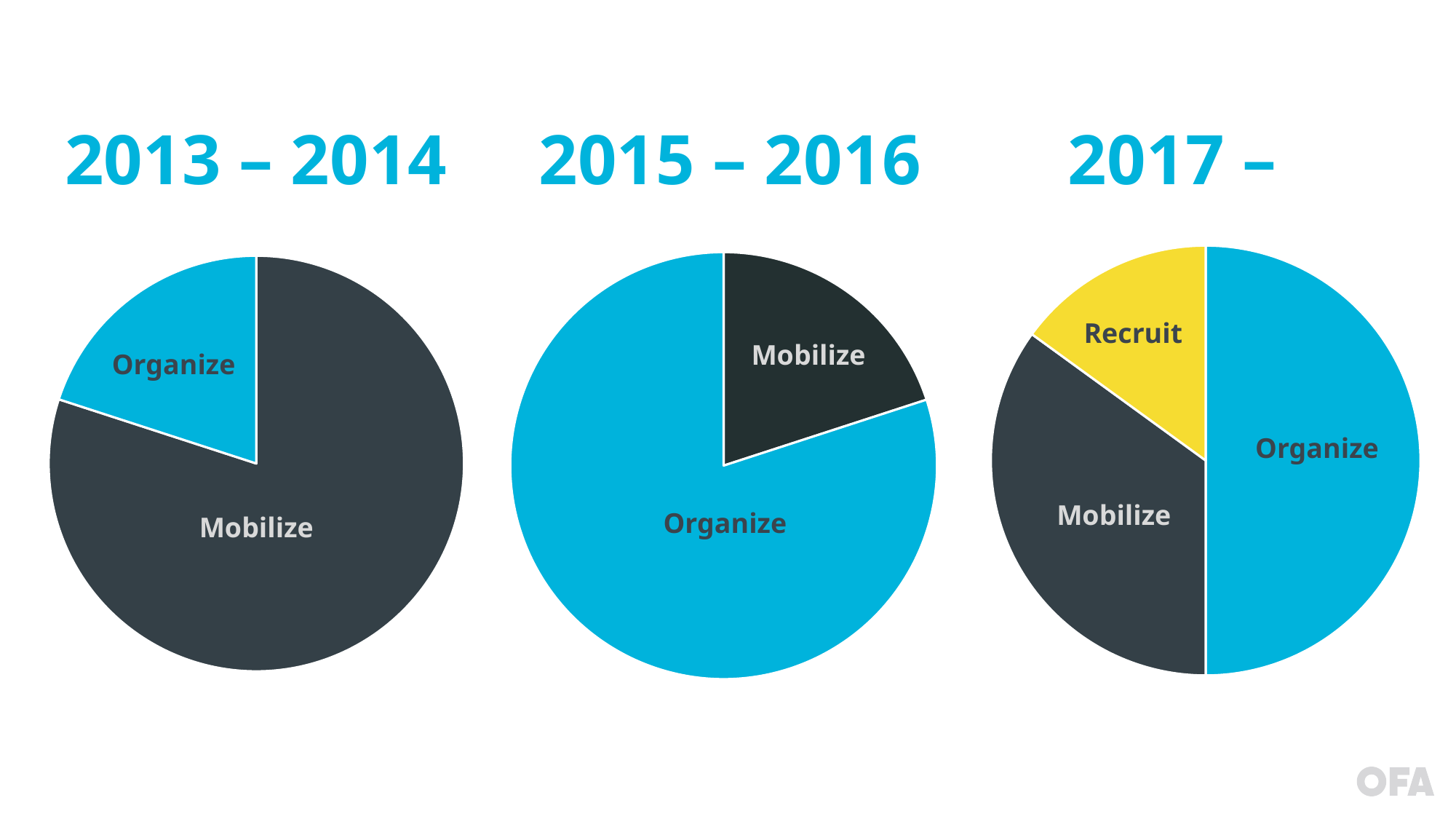
How many slices does the 2015 – 2016 pie chart have? 2 In the 2017 – pie chart, which slice is the largest? Organize In the 2017 – pie chart, which is larger, the Mobilize slice or the Recruit slice? Mobilize How many slices does the 2017 – pie chart have? 3 In the 2015 – 2016 pie chart, which slice is the smallest? Mobilize In the 2017 – pie chart, which slice is the smallest? Recruit In the 2013 – 2014 pie chart, which slice is the largest? Mobilize What kind of chart is shown under the heading 2013 – 2014? Pie chart In the 2013 – 2014 pie chart, which slice is the smallest? Organize In the 2015 – 2016 pie chart, which slice is the largest? Organize In the 2017 – pie chart, what colour is the Recruit slice? Yellow How many pie charts are on the slide? 3